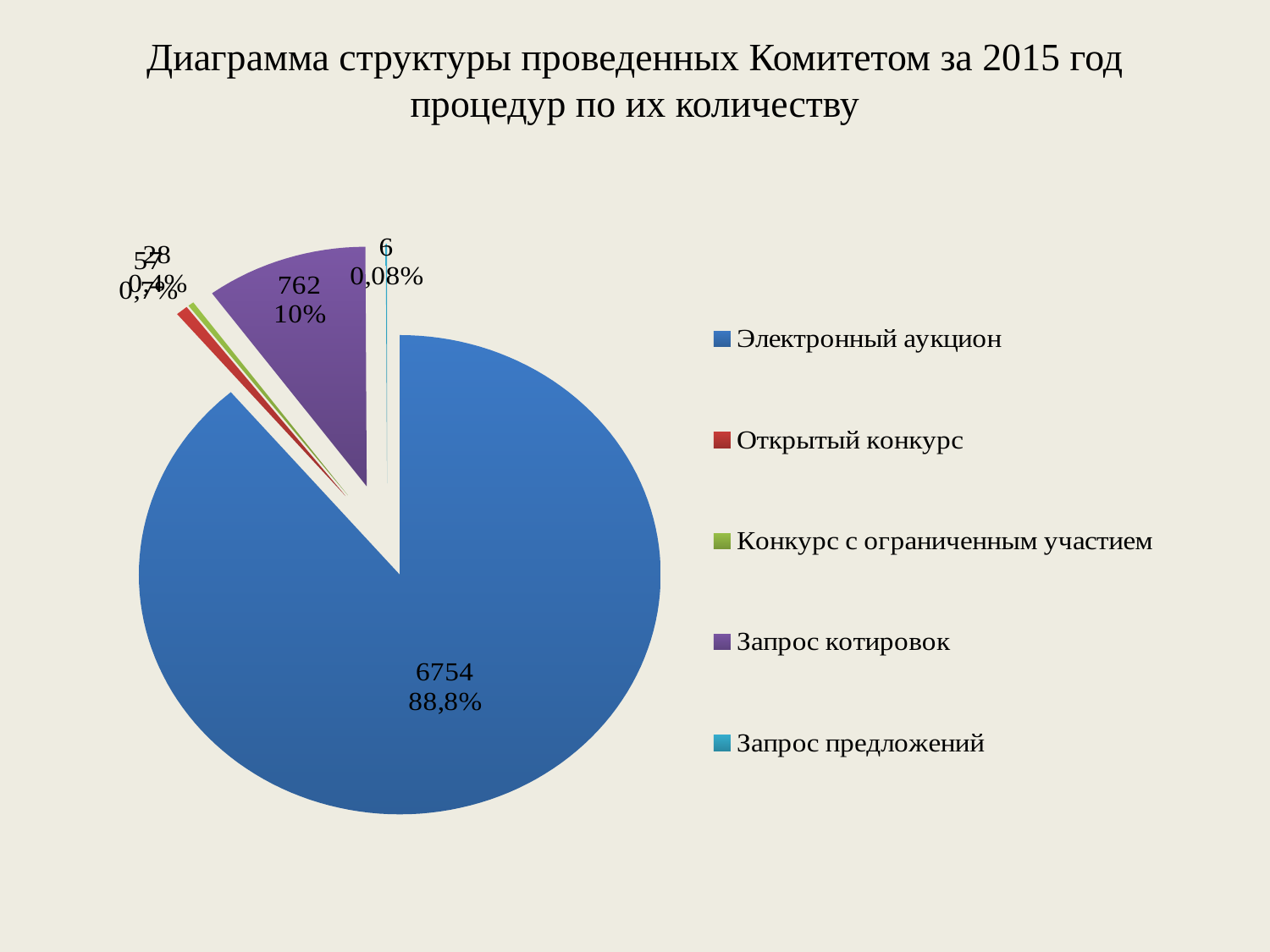
Which category has the largest slice of the pie? Электронный аукцион What share of the pie does Запрос предложений represent? 0,08% What is the value shown for Запрос котировок? 762 What is the value shown for Электронный аукцион? 6754 What is the value shown for Запрос предложений? 6 What share of the pie does Запрос котировок represent? 10% What share of the pie does Электронный аукцион represent? 88,8% Which colour is used for the Запрос котировок slice? Purple How many categories does the legend of the pie chart list? 5 Which category has the smallest slice of the pie? Запрос предложений What is the difference between the values for Электронный аукцион and Запрос котировок? 5992 What kind of chart is shown on the slide? Pie chart